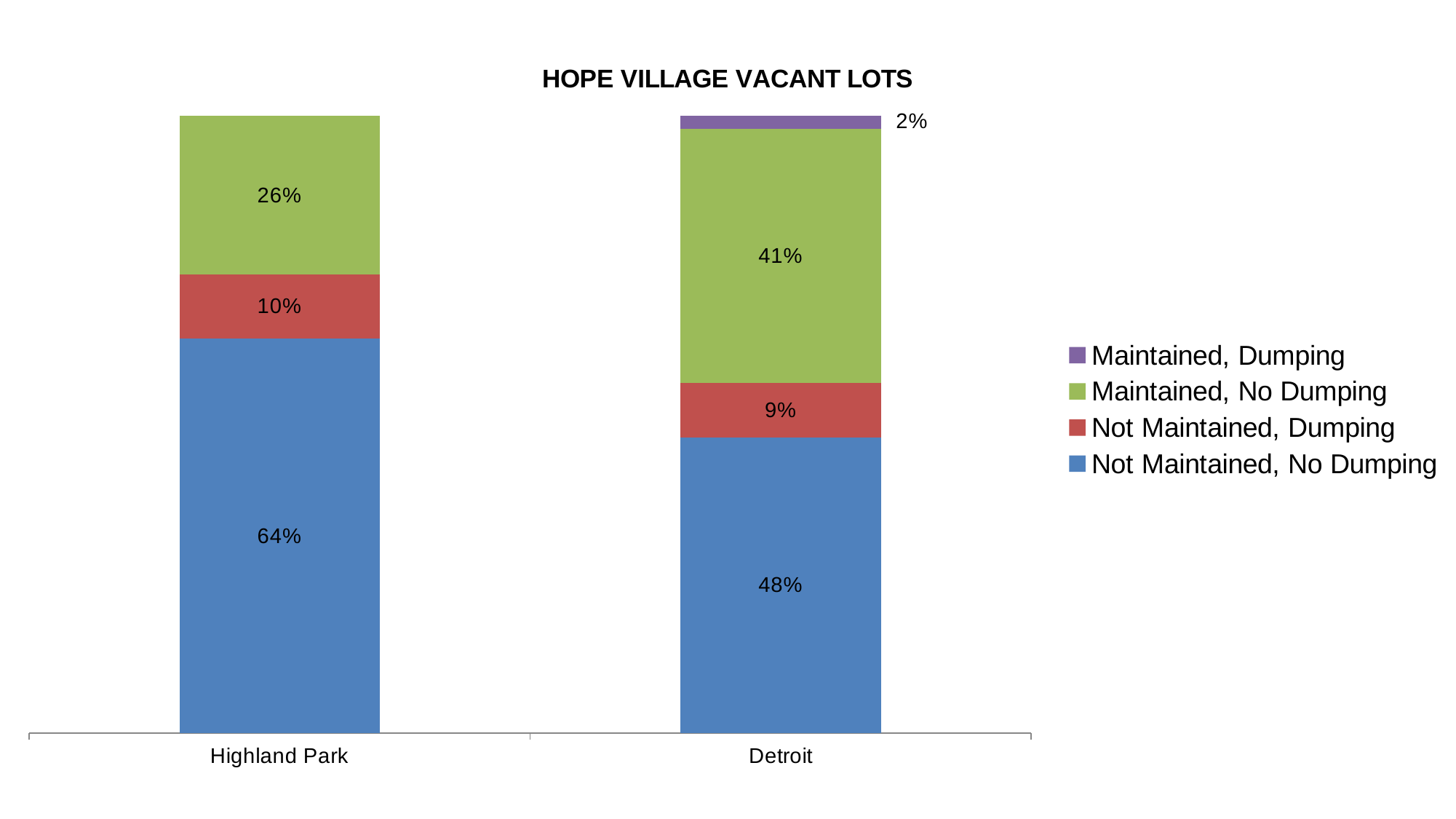
Which series has the largest share in the Highland Park bar? Not Maintained, No Dumping How many series does the legend list? 4 What percentage of Detroit vacant lots are Maintained, No Dumping? 41% What percentage of Highland Park vacant lots are Not Maintained, No Dumping? 64% Is the Maintained, No Dumping share larger in Highland Park or Detroit? Detroit What is the value for Not Maintained, Dumping in Detroit? 9% What is the total of the labelled segments in the Highland Park bar? 100% What is the value for Maintained, Dumping in Detroit? 2% What kind of chart is shown on the slide? Stacked bar chart How many categories are shown on the x axis? 2 Which series has the smallest labelled share in the Detroit bar? Maintained, Dumping How much larger is the Not Maintained, No Dumping share in Highland Park than in Detroit? 16 percentage points